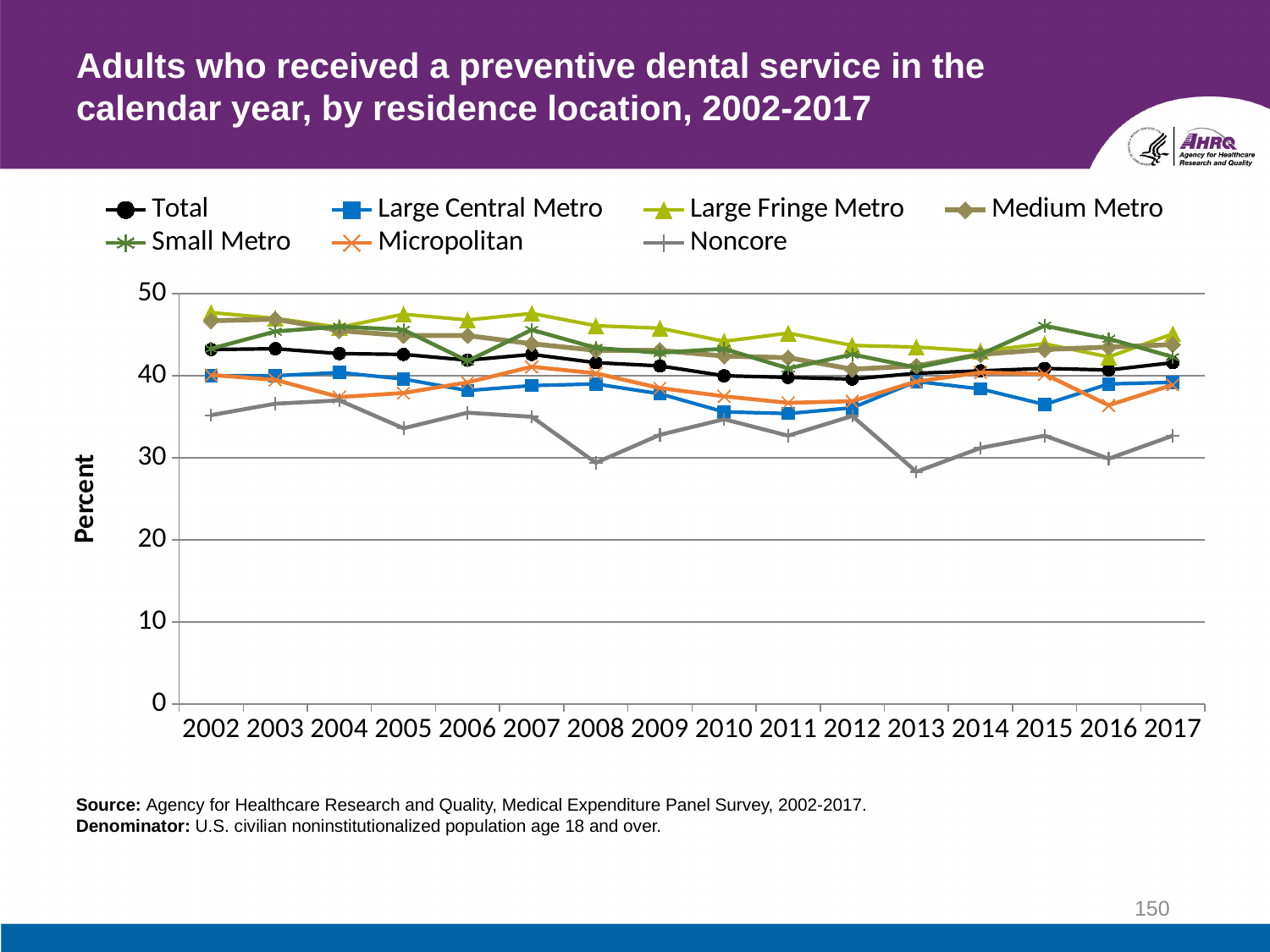
Is the value for Noncore in 2013 greater or less than 30? less Is the value for Large Fringe Metro in 2002 greater or less than 40? greater What is the label on the y axis? Percent Which series has the lowest value in 2013? Noncore Does the Noncore line rise or fall from 2012 to 2013? fall Which series has the highest value in 2007? Large Fringe Metro What kind of chart is shown on the slide? line chart Is the value for Large Central Metro in 2010 greater or less than 40? less How many series does the legend list? 7 In 2007, which is larger: Large Fringe Metro or Noncore? Large Fringe Metro How many years are plotted along the x axis? 16